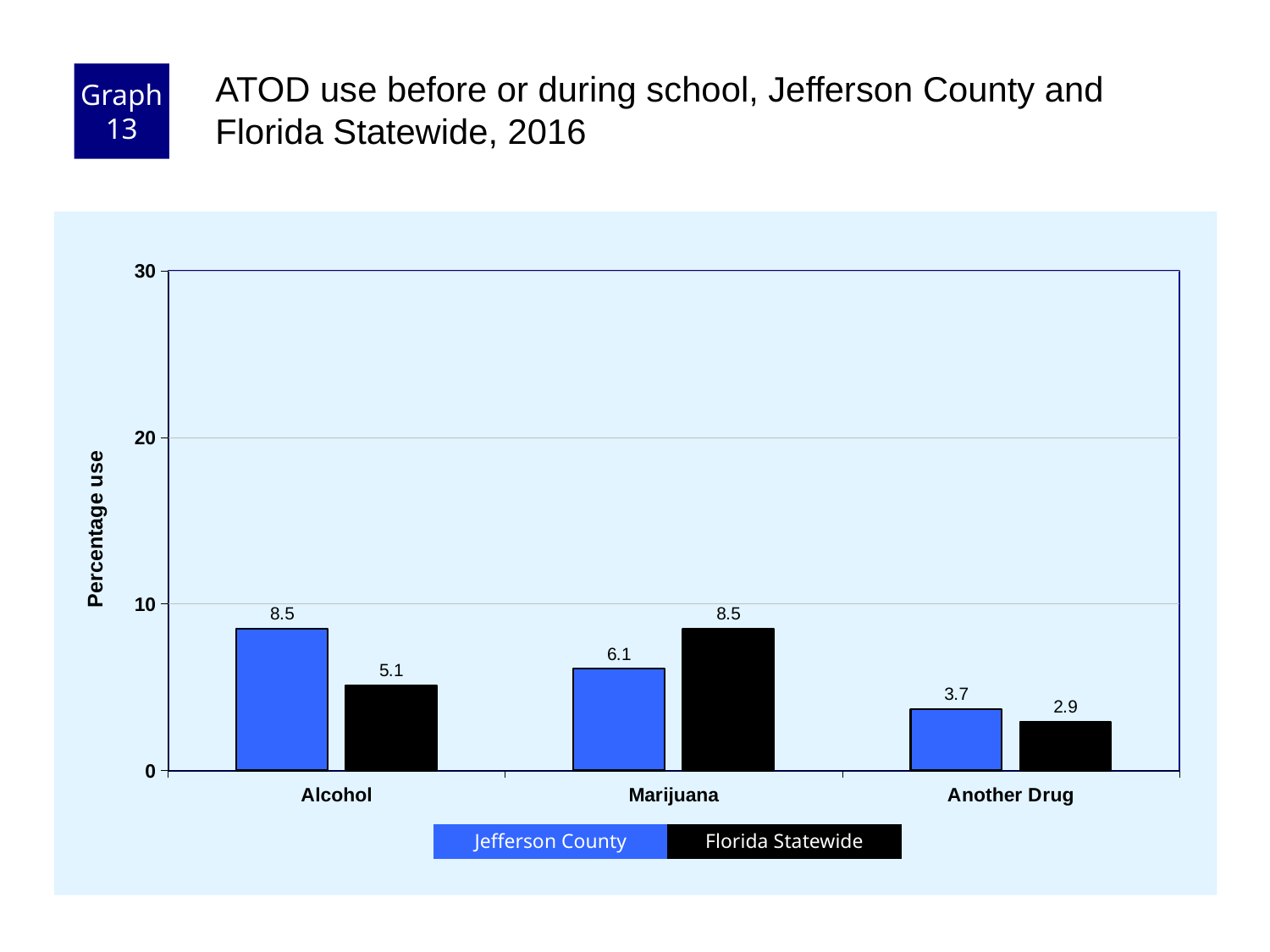
How many series does the legend list? 2 What is the Jefferson County value for Another Drug? 3.7 What kind of chart is shown on the slide? Bar chart Which category has the lowest Florida Statewide value? Another Drug What is the Florida Statewide value for Alcohol? 5.1 What is the Jefferson County value for Alcohol? 8.5 What is the Florida Statewide value for Marijuana? 8.5 Which category has the highest Jefferson County value? Alcohol What is the difference between the Jefferson County and Florida Statewide values for Alcohol? 3.4 What is the difference between the Florida Statewide and Jefferson County values for Marijuana? 2.4 Which is larger for Marijuana: Jefferson County or Florida Statewide? Florida Statewide How many categories are shown on the x axis? 3